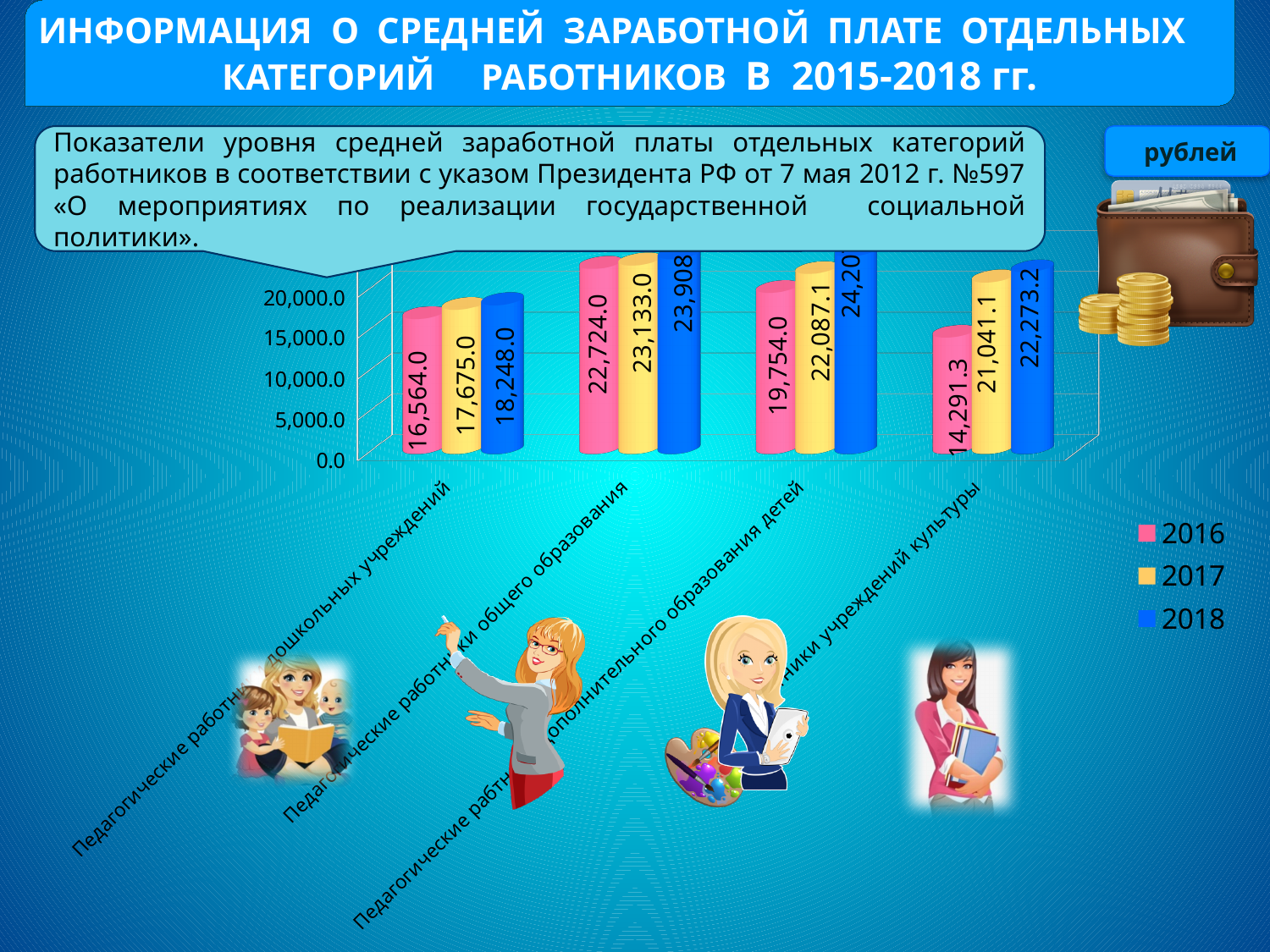
What is the 2016 value for педагогические работники дошкольных учреждений? 16,564.0 By how much did the value for педагогические работники дошкольных учреждений increase from 2016 to 2018? 1,684.0 What is the 2018 value for работники учреждений культуры? 22,273.2 How many series does the legend list? 3 What is the 2016 value for работники учреждений культуры? 14,291.3 What kind of chart is shown on the slide? Bar chart Which is larger in 2017: the value for педагогические работники общего образования or for педагогические работники дополнительного образования детей? Педагогические работники общего образования What is the 2018 value for педагогические работники дошкольных учреждений? 18,248.0 Is the 2018 value for педагогические работники дополнительного образования детей greater or less than 20,000.0? greater What is the difference between the 2017 and 2016 values for работники учреждений культуры? 6,749.8 What is the 2017 value for педагогические работники общего образования? 23,133.0 Which category has the lowest 2016 value? Работники учреждений культуры